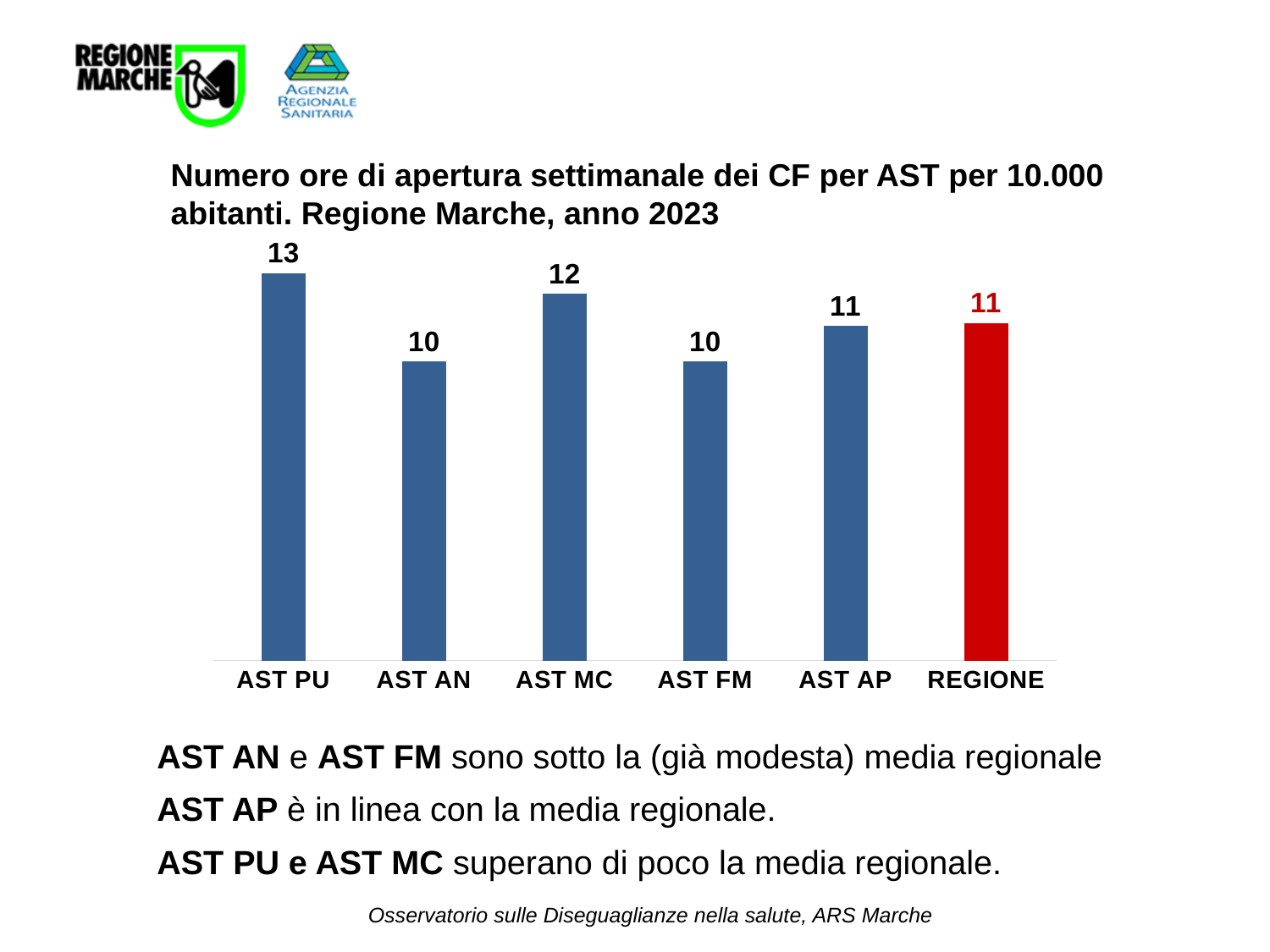
What is the difference between the values for AST PU and AST AN? 3 What is the value for AST PU? 13 What is the value for AST FM? 10 Which category has the highest value? AST PU Which is larger, the value for AST MC or the value for AST AP? AST MC What is the difference between the values for AST MC and REGIONE? 1 What is the value for AST MC? 12 How many categories are shown on the x axis? 6 Which year does the chart title refer to? 2023 Which bar is coloured red instead of blue? REGIONE What is the value for REGIONE? 11 What kind of chart is shown on the slide? Bar chart